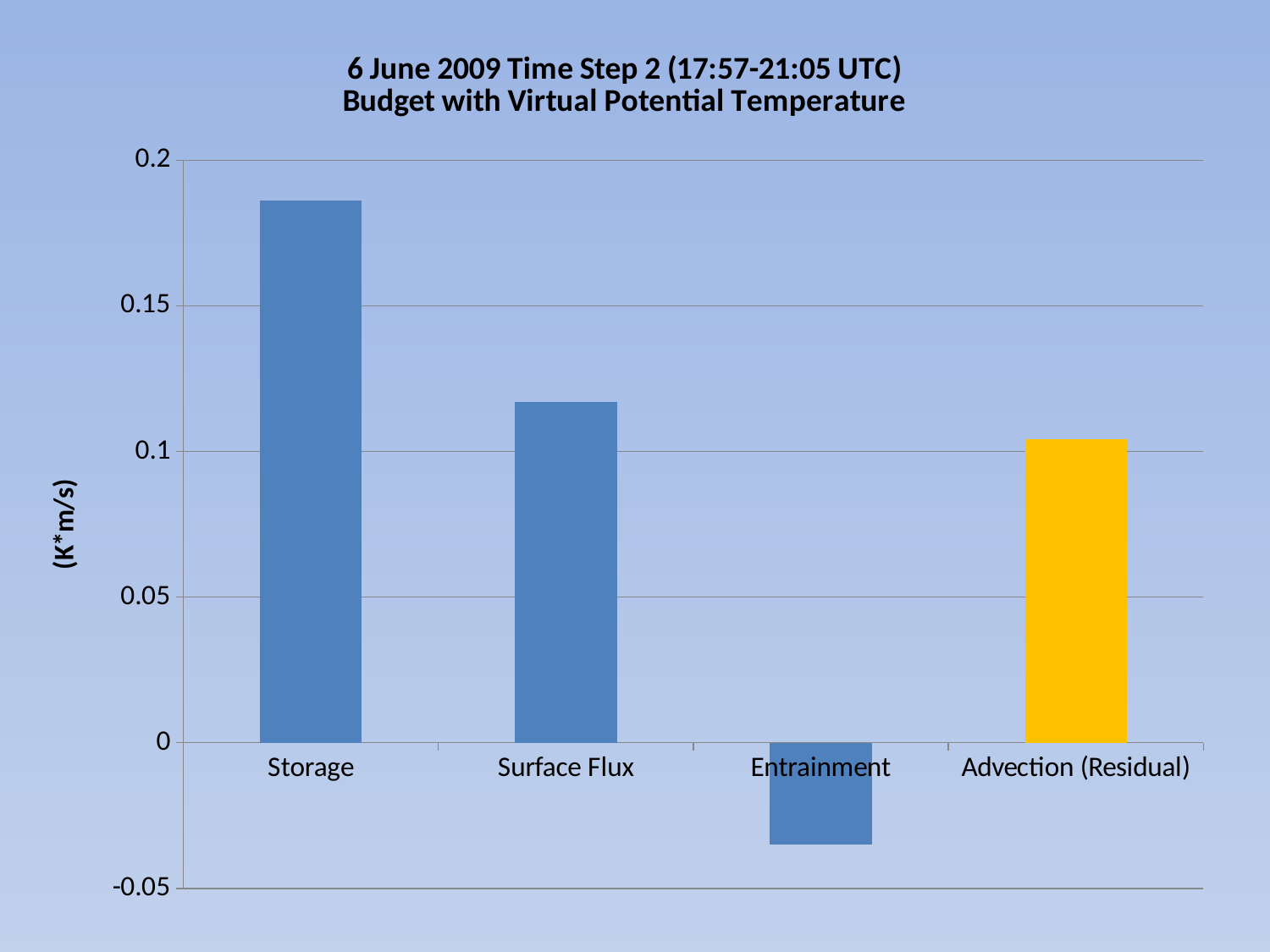
Which category has the highest value? Storage Is the value for Surface Flux greater or less than 0.1? greater Which is larger, the value for Storage or the value for Surface Flux? Storage Which category is the only one with a negative value? Entrainment Is the value for Advection (Residual) greater or less than 0.15? less Is the value for Entrainment greater or less than 0? less Which category has the lowest value? Entrainment How many categories are plotted on the chart? 4 What kind of chart is shown on the slide? Bar chart Which is larger, the value for Surface Flux or the value for Advection (Residual)? Surface Flux What unit is shown on the vertical axis label? (K*m/s)